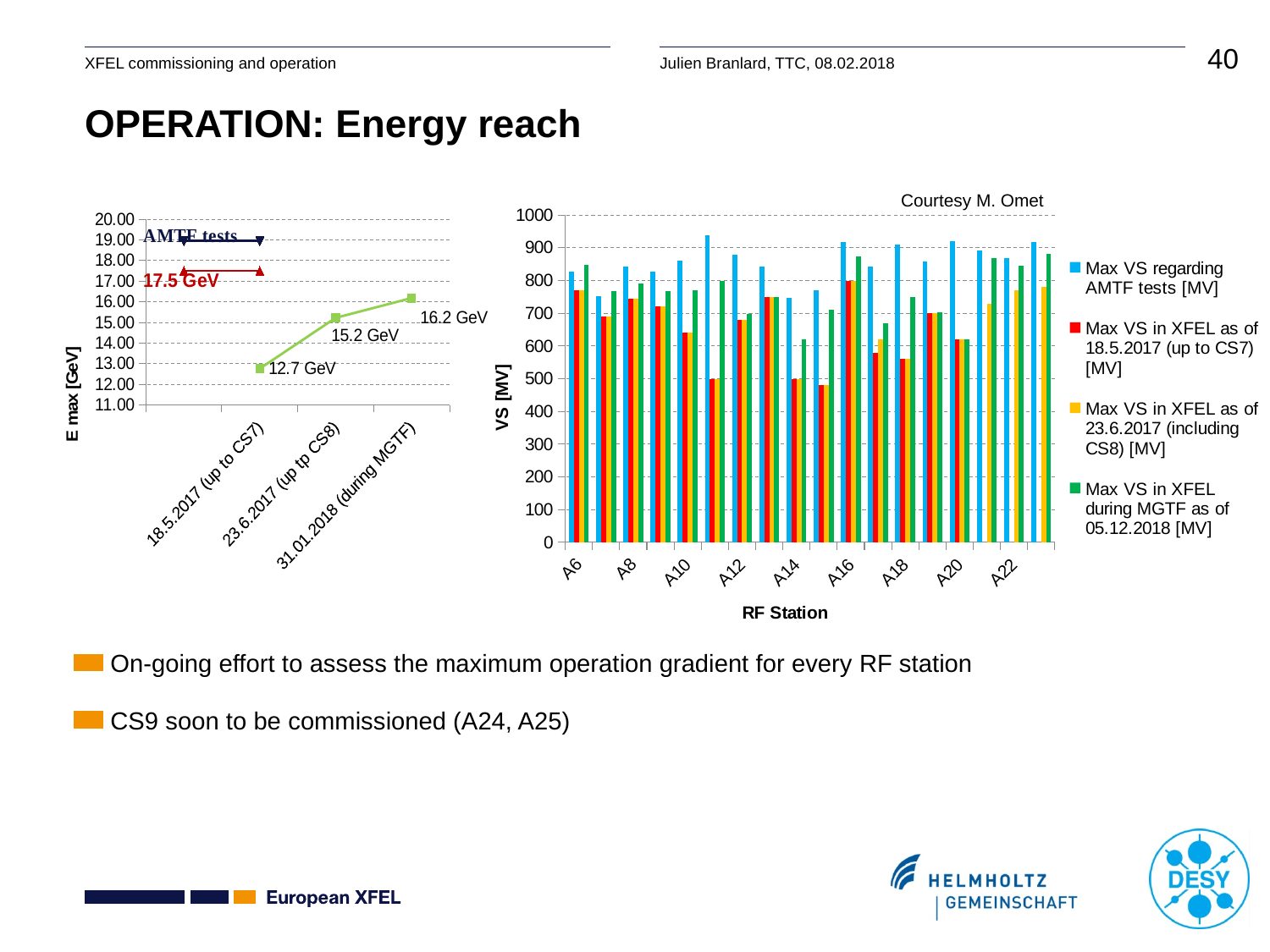
In the left chart (E max [GeV]), how many dates are plotted on the x axis? 3 In the left chart (E max [GeV]), what is the value for 18.5.2017 (up to CS7)? 12.7 GeV What kind of chart is the right chart (VS [MV] vs RF Station)? bar chart How many series does the legend of the right chart (VS [MV] vs RF Station) list? 4 In the right chart (VS [MV] vs RF Station), is the value of Max VS regarding AMTF tests [MV] for A10 greater or less than 800? greater In the left chart (E max [GeV]), what is the difference between the values for 31.01.2018 (during MGTF) and 18.5.2017 (up to CS7)? 3.5 GeV In the right chart (VS [MV] vs RF Station), for A10, which is larger: Max VS regarding AMTF tests [MV] or Max VS in XFEL as of 18.5.2017 (up to CS7) [MV]? Max VS regarding AMTF tests [MV] In the right chart (VS [MV] vs RF Station), is the value of Max VS in XFEL as of 18.5.2017 (up to CS7) [MV] for A14 greater or less than 600? less In the left chart (E max [GeV]), which date has the highest E max value? 31.01.2018 (during MGTF) What is the x-axis title of the right chart? RF Station In the left chart (E max [GeV]), do the plotted values rise or fall from left to right along the x axis? rise In the left chart (E max [GeV]), what is the value for 31.01.2018 (during MGTF)? 16.2 GeV